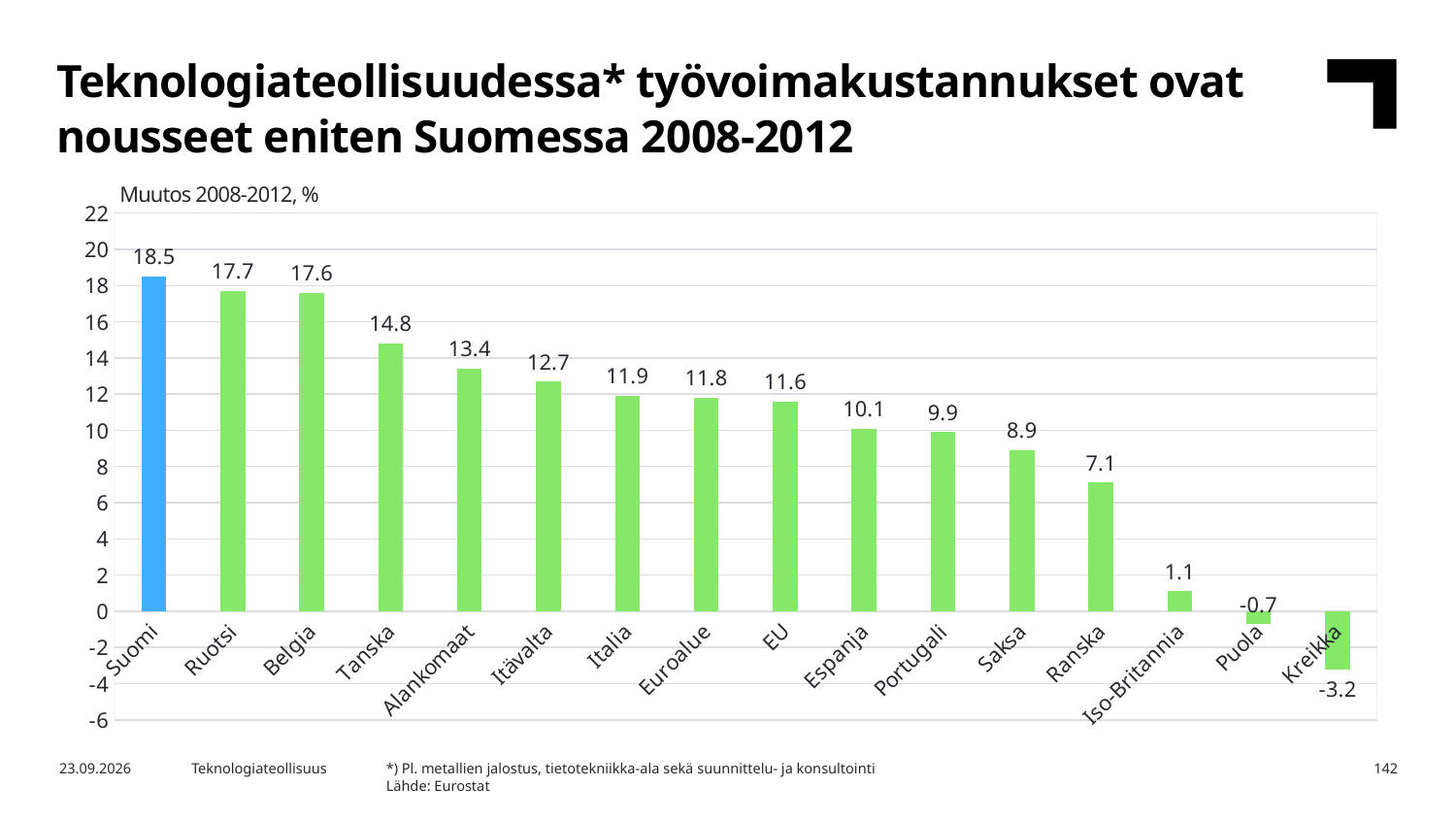
What is the difference between the values for Tanska and Saksa? 5.9 Do the values rise or fall from left to right along the x axis? Fall What kind of chart is shown on the slide? Bar chart Which country has the highest value? Suomi How many categories are shown on the x axis? 16 What is the difference between the values for Suomi and Ruotsi? 0.8 What is the value for Suomi? 18.5 Which is larger, the value for Espanja or the value for Ranska? Espanja Which bar is coloured differently from the others? Suomi Which country has the lowest value? Kreikka What is the value for Kreikka? -3.2 What is the value for Alankomaat? 13.4